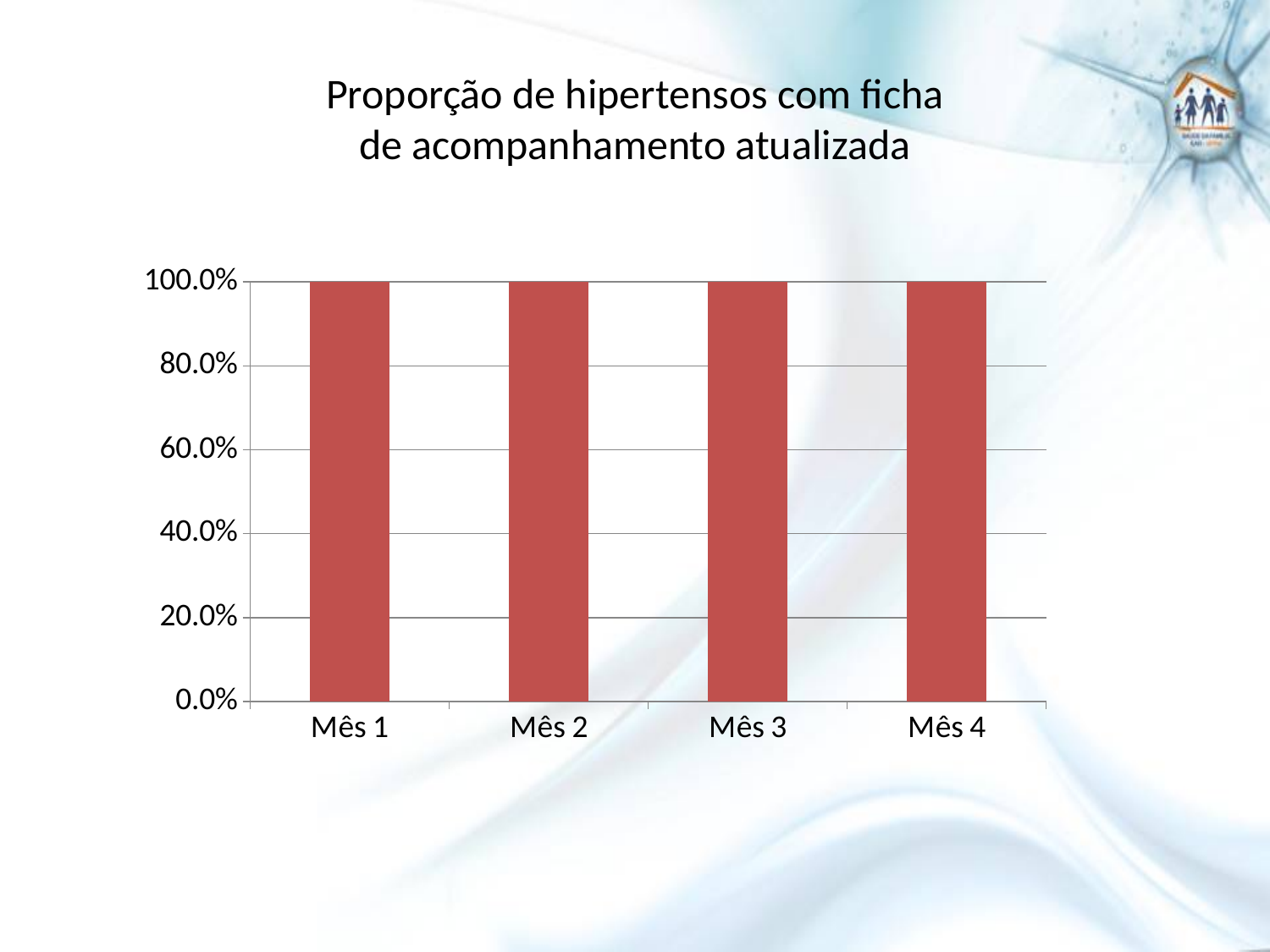
What kind of chart is shown on the slide? bar chart What colour are the bars in the chart? red What is the title of the chart? Proporção de hipertensos com ficha de acompanhamento atualizada Do the values rise, fall, or stay the same from Mês 1 to Mês 4? stay the same What is the value for Mês 2? 100.0% Is the value for Mês 1 greater or less than 60.0%? greater What is the value for Mês 1? 100.0% What is the difference between the values for Mês 4 and Mês 1? 0.0% What is the value for Mês 4? 100.0% How many categories (months) are shown on the x axis? 4 Is the value for Mês 3 greater or less than 80.0%? greater What is the value for Mês 3? 100.0%